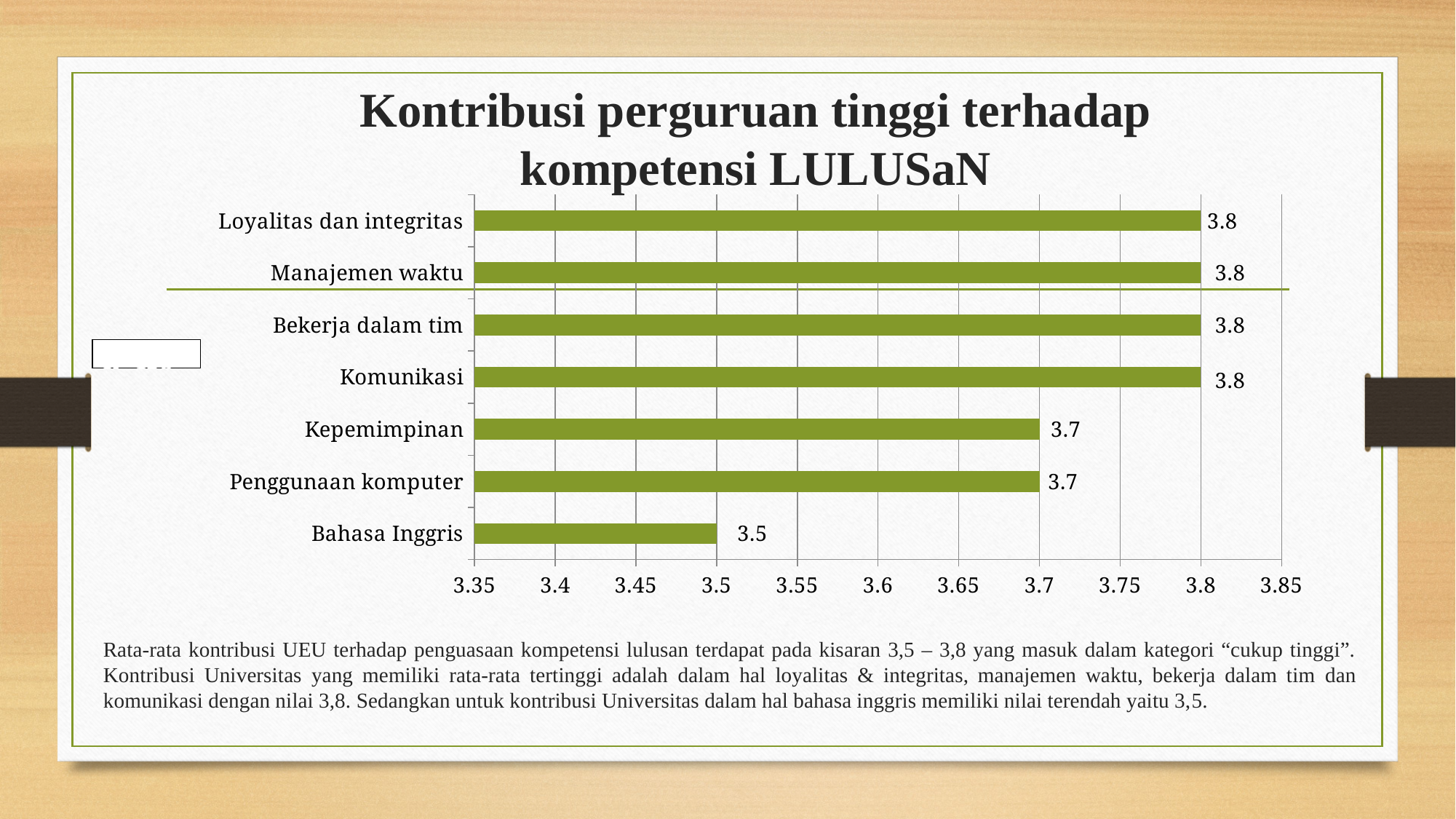
Which is larger, the value for Manajemen waktu or the value for Penggunaan komputer? Manajemen waktu What is the value for Kepemimpinan? 3.7 What is the value for Komunikasi? 3.8 What kind of chart is shown on the slide? bar chart What is the title of the chart? Kontribusi perguruan tinggi terhadap kompetensi LULUSaN What is the difference between the values for Loyalitas dan integritas and Bahasa Inggris? 0.3 How many categories are shown in the chart? 7 What is the value for Bahasa Inggris? 3.5 Is the value for Bahasa Inggris greater or less than 3.6? less What is the difference between the values for Kepemimpinan and Bahasa Inggris? 0.2 Which category has the lowest value? Bahasa Inggris What is the value for Penggunaan komputer? 3.7